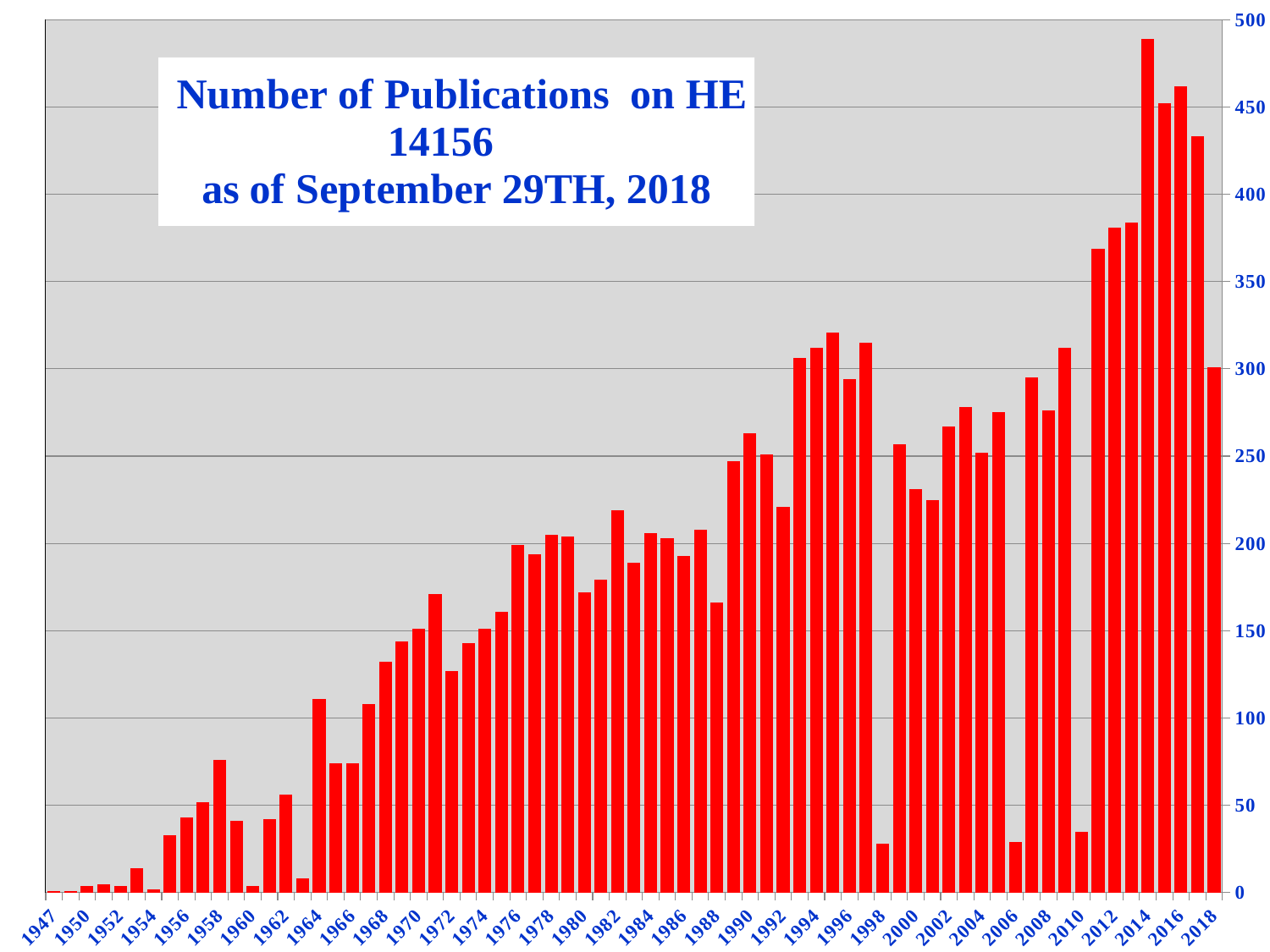
Is the value for 2012 greater or less than 350? greater Is the value for 1972 greater or less than 150? less Is the value for 1988 greater or less than 200? less What kind of chart is shown on the slide? bar chart Which year has the highest number of publications? 2014 Which year has more publications, 2014 or 2016? 2014 Which year has more publications, 1990 or 1995? 1995 What is the title of the chart? Number of Publications on HE 14156 as of September 29TH, 2018